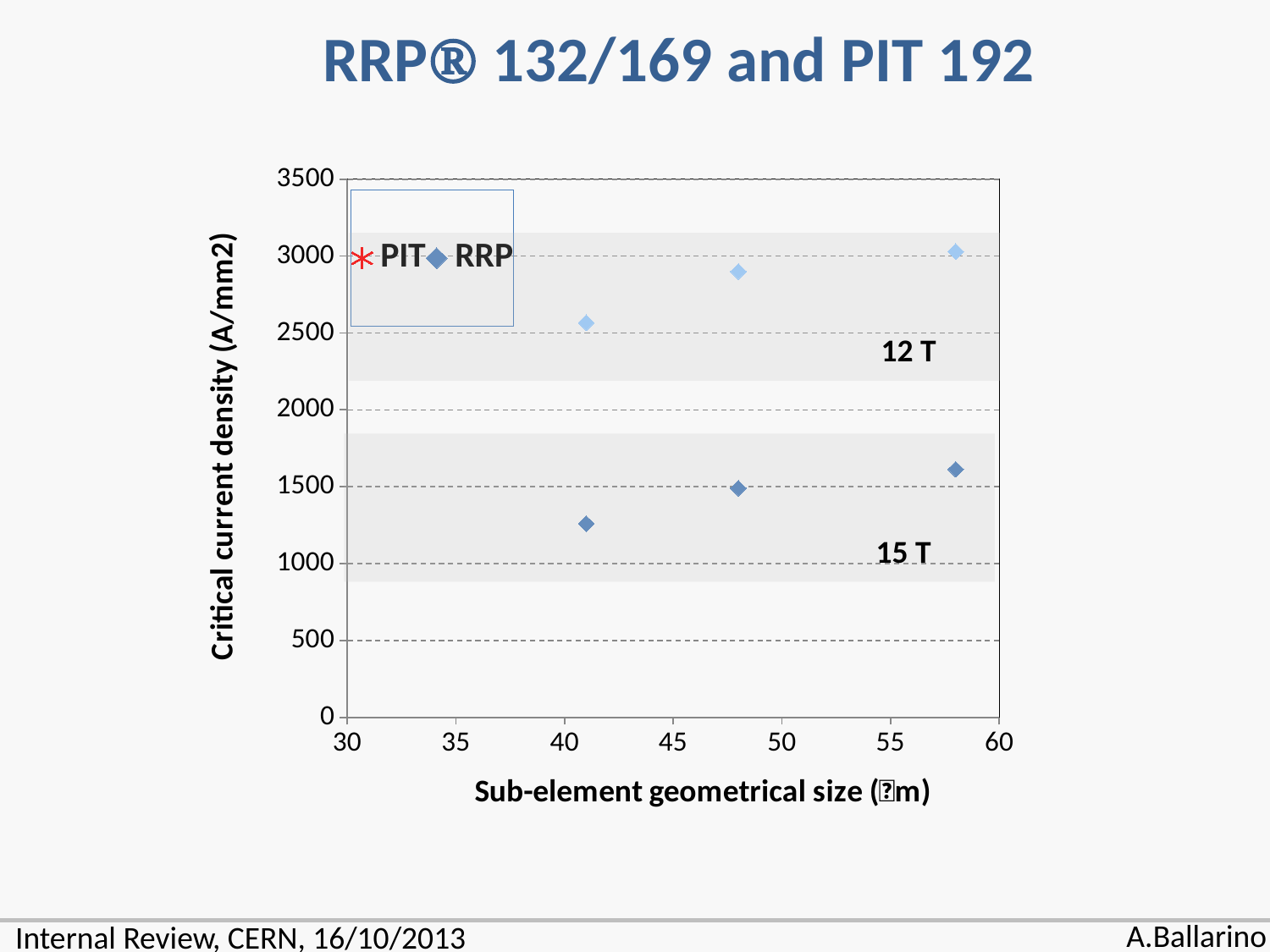
In the 12 T band, is the value at a sub-element size of 48 greater or less than 2500? greater How many data points are plotted on the chart? 6 What is the title of the y axis? Critical current density (A/mm2) In the 12 T band, is the value at a sub-element size of 41 greater or less than 3000? less How many series does the legend list? 2 Do the critical current density values rise or fall as the sub-element geometrical size increases? rise At which sub-element geometrical size is the highest critical current density plotted? 58 In the 12 T band, which sub-element size has the larger critical current density, 41 or 58? 58 In the 15 T band, is the value at a sub-element size of 41 greater or less than 1500? less Which two series are listed in the legend? PIT and RRP What kind of chart is shown on the slide? scatter chart